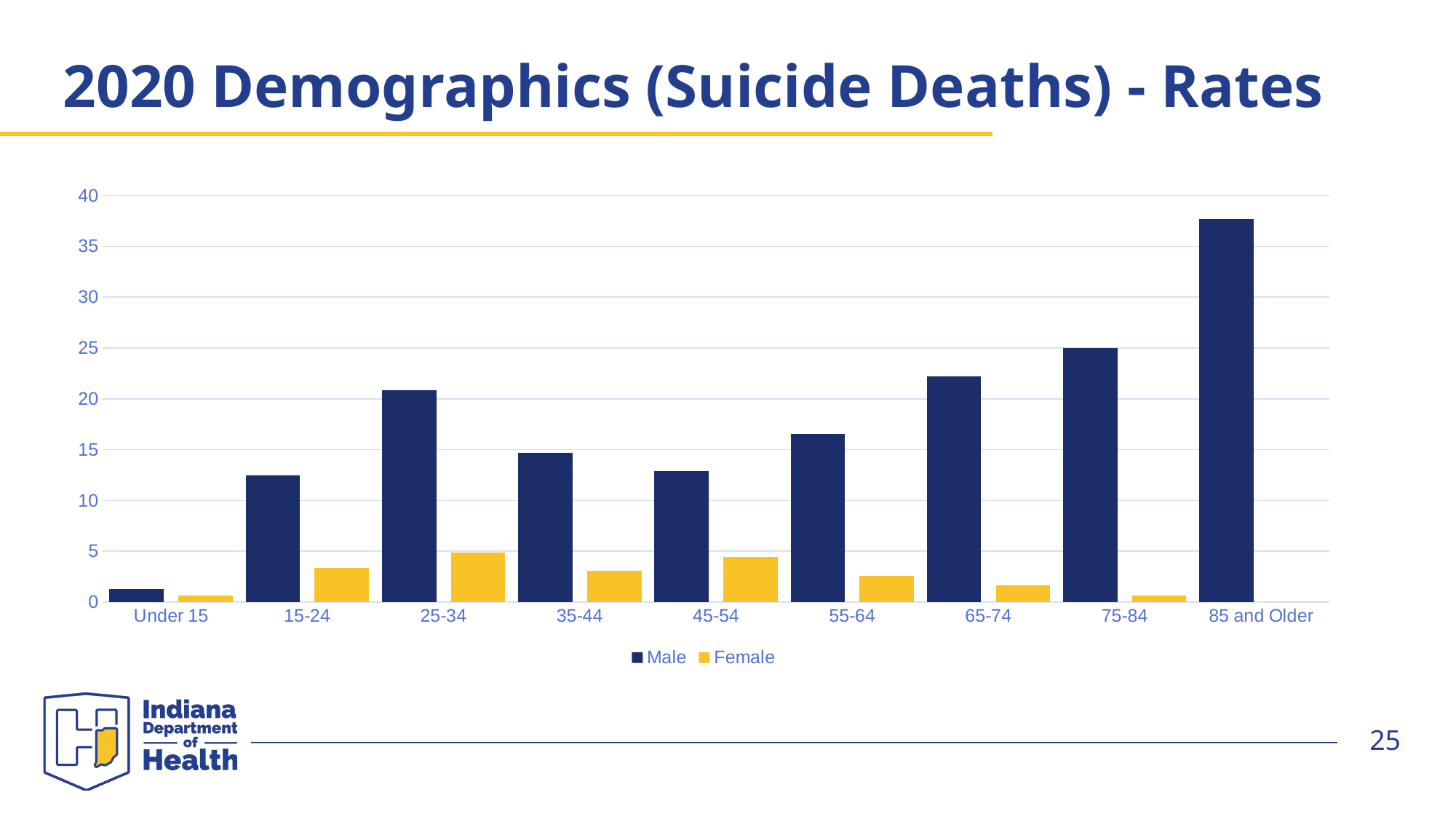
Is the Male value for 55-64 greater or less than 15? greater What is the title of the chart on the slide? 2020 Demographics (Suicide Deaths) - Rates Which age group has the lowest Male rate? Under 15 Which age group has the highest Male rate? 85 and Older How many age groups are shown on the x axis? 9 Which is larger, the Male value for 25-34 or the Male value for 35-44? 25-34 How many series does the legend list? 2 What kind of chart is shown on the slide? Bar chart Which is larger, the Female value for 15-24 or the Female value for 65-74? 15-24 Is the Male value for 65-74 greater or less than 20? greater Is the Male value for 85 and Older greater or less than 35? greater